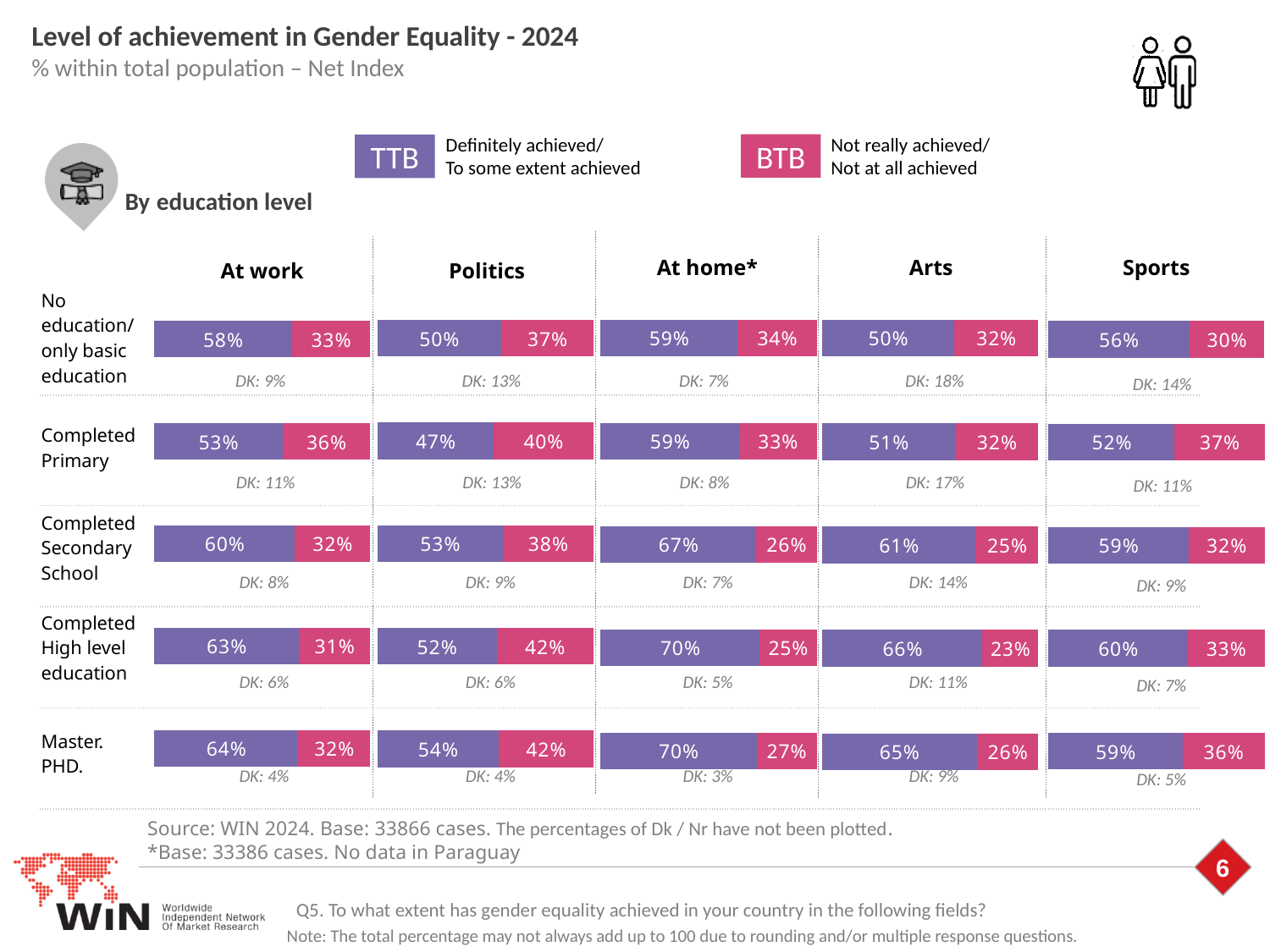
In the Arts chart, what is the TTB value for Completed High level education? 66% How many series does the legend list for these charts? 2 In the Arts chart, which education level has the lowest BTB value? Completed High level education In the At home* chart, what is the total of the TTB and BTB values for Completed Primary? 92% What kind of chart is used for the At home* panel? Stacked bar chart How many education-level categories are shown in the Sports chart? 5 In the Politics chart, which is larger: the TTB value for No education/only basic education or for Completed Secondary School? Completed Secondary School In the Politics chart, what is the BTB value for Master. PHD.? 42% In the At work chart, what is the difference between the TTB and BTB values for Completed Secondary School? 28 percentage points In the At work chart, which education level has the highest TTB value? Master. PHD. In the Politics chart, which education level has the lowest TTB value? Completed Primary In the At work chart, what is the TTB value for Completed Secondary School? 60%